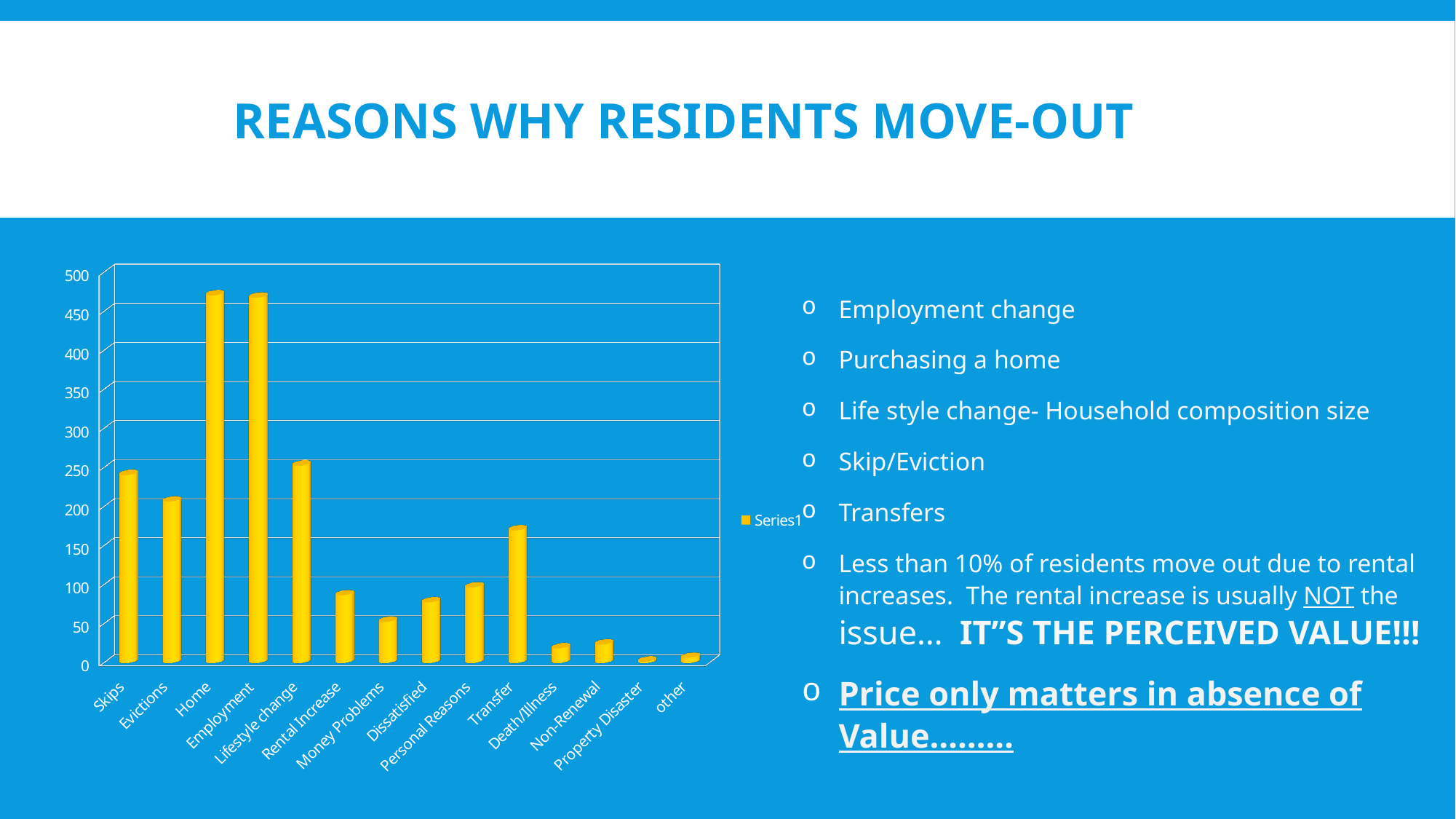
Is the value for Transfer greater or less than 200? less Is the value for Skips greater or less than 200? greater How many categories are plotted on the x axis of the chart? 14 How many series does the chart's legend list? 1 What colour are the bars in the chart? Yellow Which has the larger value, Lifestyle change or Money Problems? Lifestyle change Is the value for Rental Increase greater or less than 100? less Which has the larger value, Skips or Evictions? Skips What is the name of the series shown in the chart's legend? Series1 What kind of chart is shown on the slide? Bar chart Which has the larger value, Transfer or Personal Reasons? Transfer